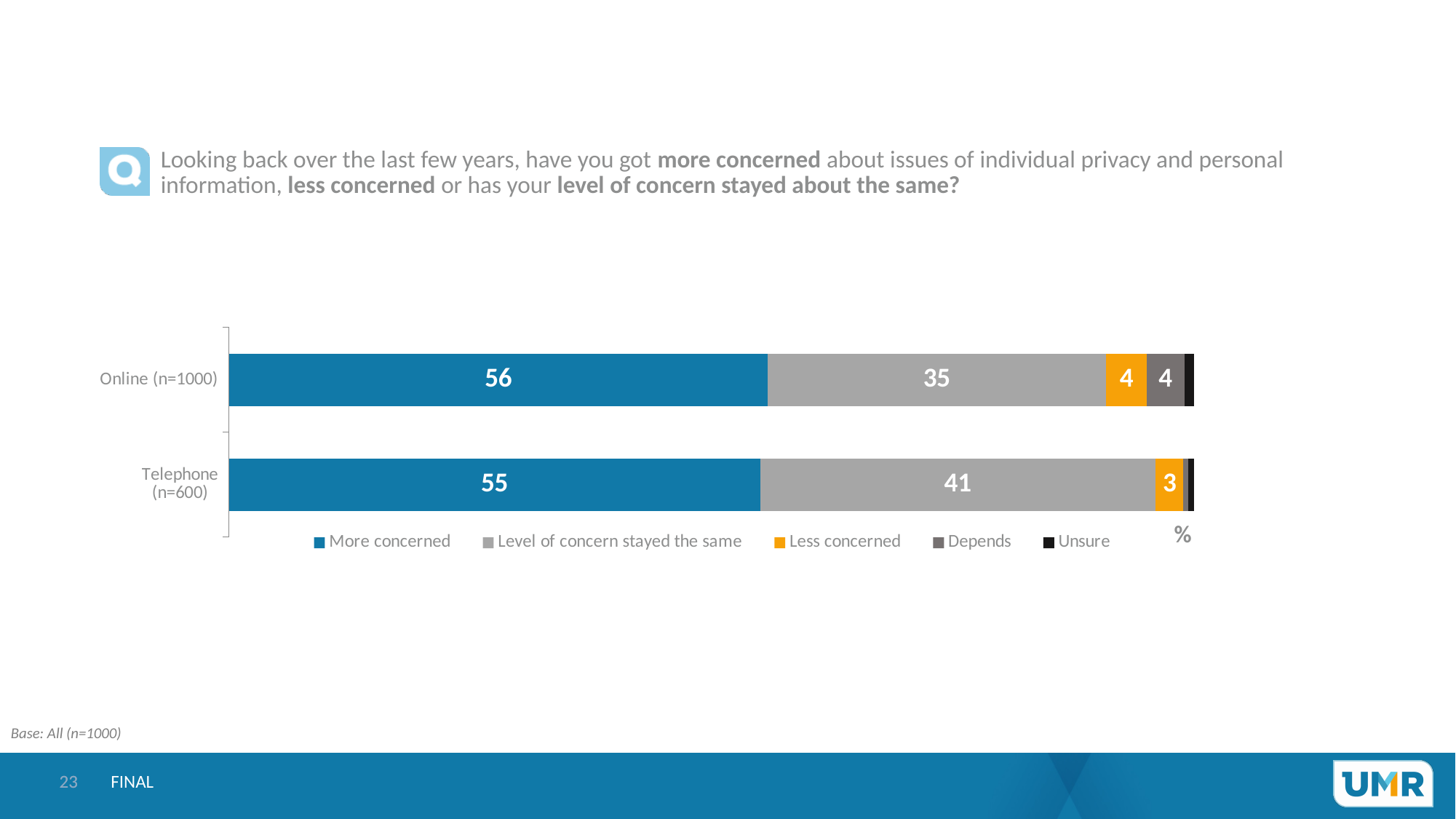
What colour represents the Less concerned series in the chart? Orange What percentage of Telephone respondents said their level of concern stayed the same? 41 What percentage of Online respondents said they are more concerned? 56 What is the value for Depends among Online respondents? 4 What is the difference between the More concerned values for Online and Telephone? 1 Which series has the largest value in the Online bar? More concerned Which category has the higher value for Level of concern stayed the same, Online or Telephone? Telephone How many series does the legend list? 5 What is the difference between the Level of concern stayed the same values for Telephone and Online? 6 What is the value for Less concerned among Telephone respondents? 3 How many categories (bars) are shown in the chart? 2 What kind of chart is shown on the slide? Stacked bar chart